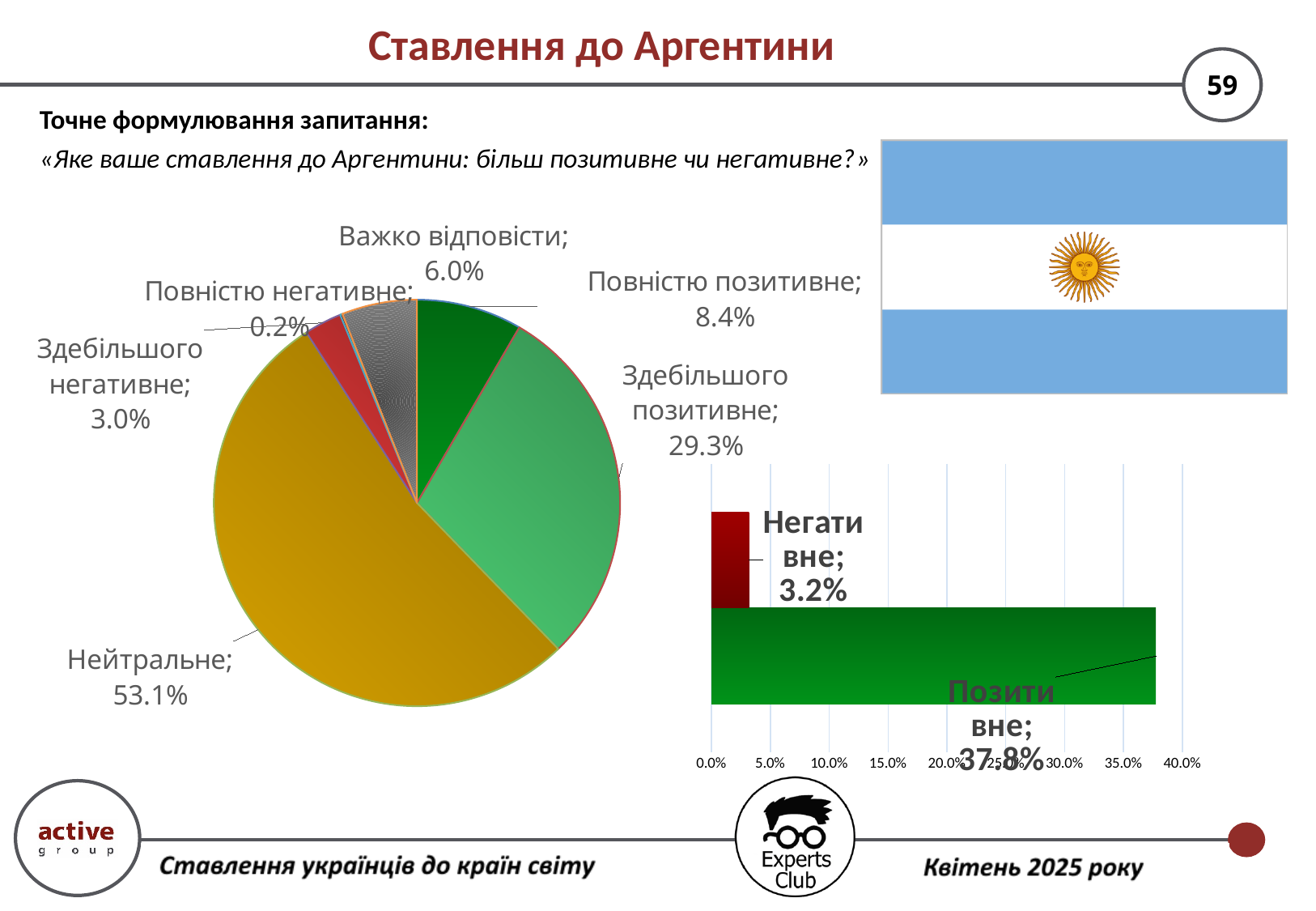
In the bar chart on the lower right, what is the difference between "Позитивне" and "Негативне"? 34.6% In the bar chart on the lower right, what is the value for "Негативне"? 3.2% In the pie chart on the left, what share is labelled for "Здебільшого позитивне"? 29.3% In the pie chart on the left, which category has the largest slice? Нейтральне In the pie chart on the left, which category has the smallest slice? Повністю негативне In the pie chart on the left, what share is labelled for "Нейтральне"? 53.1% What kind of chart is shown on the lower right of the slide? Bar chart In the pie chart on the left, what is the difference between "Повністю позитивне" and "Важко відповісти"? 2.4% In the pie chart on the left, which is larger: "Здебільшого негативне" or "Важко відповісти"? Важко відповісти In the bar chart on the lower right, what is the value for "Позитивне"? 37.8% In the pie chart on the left, what share is labelled for "Повністю негативне"? 0.2% In the pie chart on the left, how many slices are there? 6